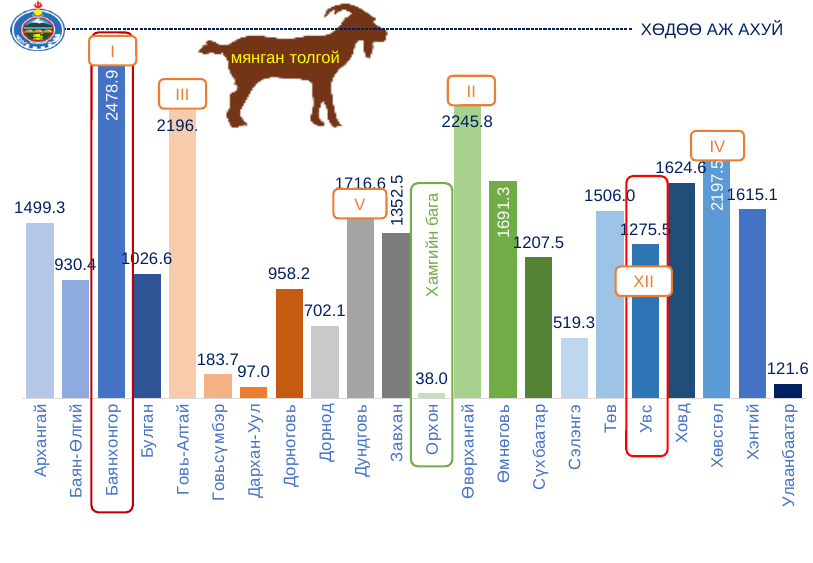
What is the difference between the values for Баянхонгор and Өвөрхангай? 233.1 Which is larger, the value for Дундговь or the value for Завхан? Дундговь Which category has the highest value? Баянхонгор What is the value for Орхон? 38.0 Which category has the lowest value? Орхон What is the value for Өвөрхангай? 2245.8 What unit label is written in yellow at the top of the chart? мянган толгой What is the value for Улаанбаатар? 121.6 What kind of chart is shown on the slide? bar chart What is the value for Баянхонгор? 2478.9 What is the value for Увс? 1275.5 How many categories are shown on the x axis? 22